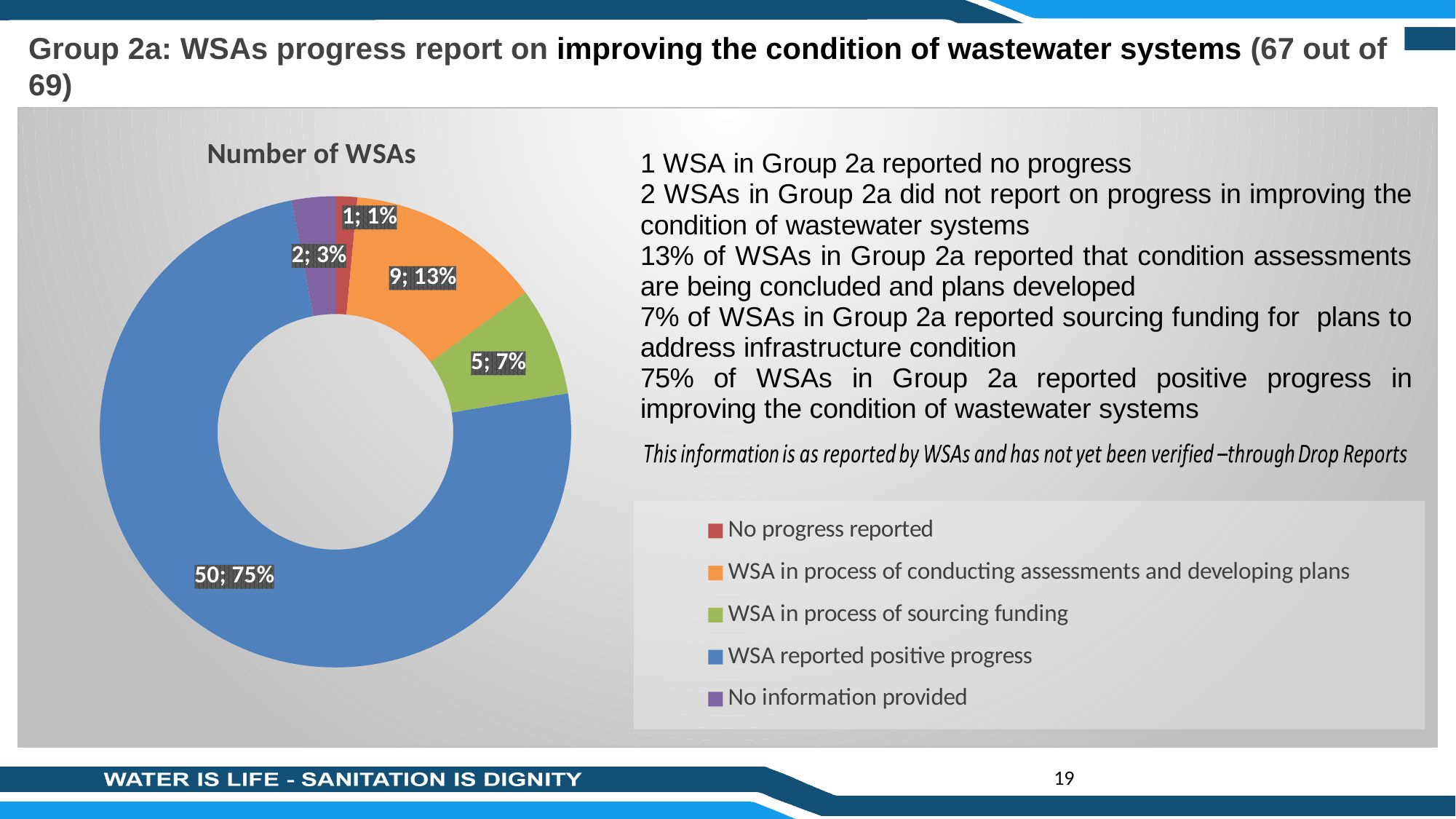
How many WSAs reported positive progress? 50 What share of the chart is 'No progress reported'? 1% What kind of chart is shown on the slide? Doughnut (pie) chart How many WSAs provided no information? 2 How many WSAs are in process of sourcing funding? 5 Which category has the smallest slice? No progress reported What is the title of the chart? Number of WSAs What share of the chart is 'WSA reported positive progress'? 75% Which category has the largest slice? WSA reported positive progress How many WSAs are in process of conducting assessments and developing plans? 9 What is the difference between the number of WSAs in process of conducting assessments and developing plans and the number in process of sourcing funding? 4 How many categories does the legend list? 5